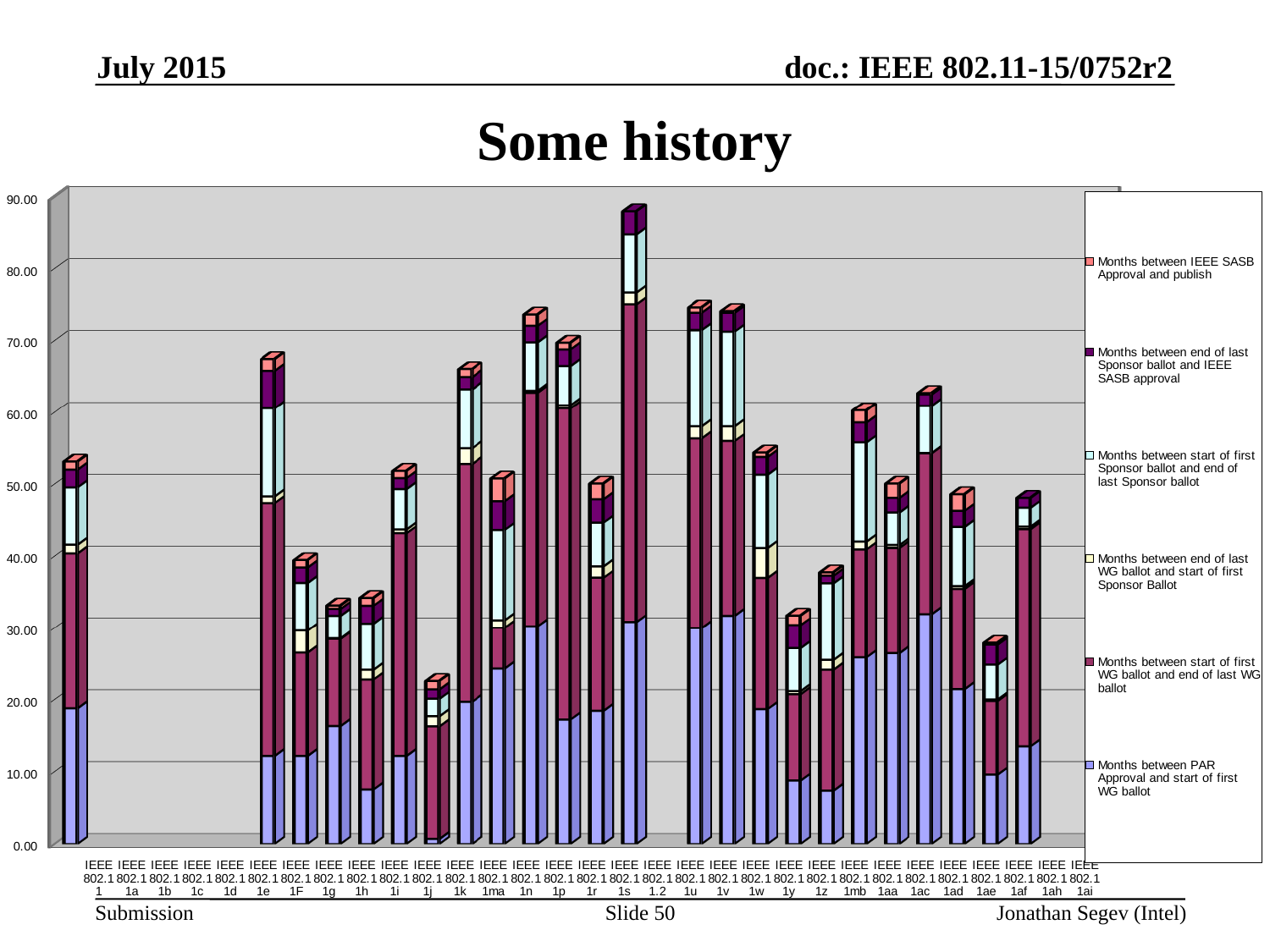
What kind of chart is shown on the slide? Stacked bar chart Is the total stacked value for IEEE 802.11e greater or less than 60? greater Is the total stacked value for IEEE 802.11w greater or less than 50? greater Which legend entry corresponds to the bottom segment of each stacked bar? Months between PAR Approval and start of first WG ballot Is the total stacked value for IEEE 802.11j greater or less than 30? less What is the title of the slide containing the chart? Some history Which category has the tallest stacked bar? IEEE 802.11s Which has the taller stacked bar, IEEE 802.11j or IEEE 802.11k? IEEE 802.11k How many series does the legend list? 6 Which has the taller stacked bar, IEEE 802.11s or IEEE 802.11e? IEEE 802.11s